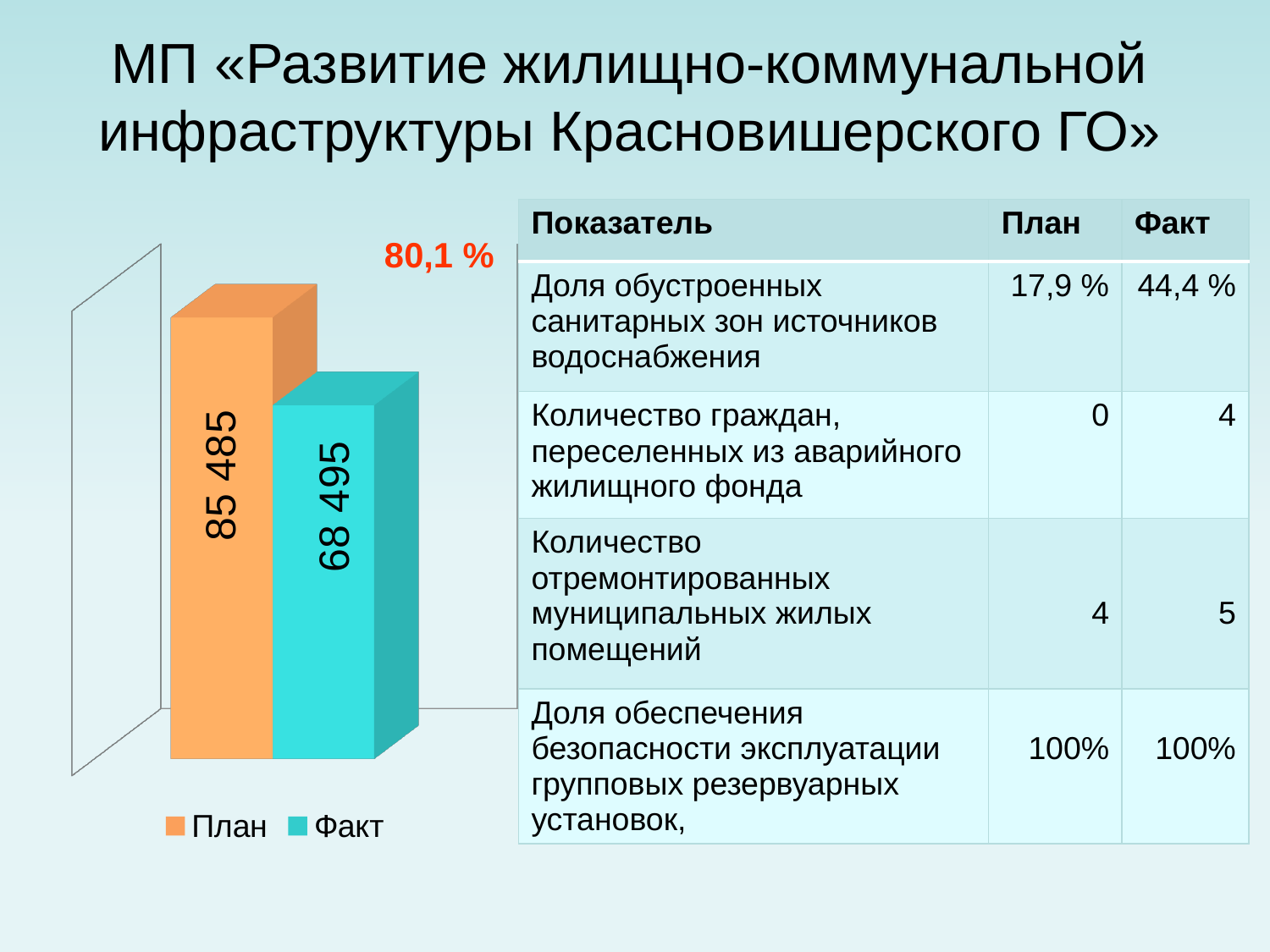
What kind of chart is shown on the slide? Bar chart What is the value of the Факт bar in the chart? 68 495 What is the difference between the План and Факт values in the chart? 16 990 Which series has the lowest value in the chart? Факт Which bar in the chart is higher, План or Факт? План What colour is the Факт bar in the chart? Turquoise What is the value of the План bar in the chart? 85 485 How many bars are plotted in the chart? 2 How many series does the chart legend list? 2 Which series has the highest value in the chart? План What percentage is printed in red above the bars in the chart? 80,1 %